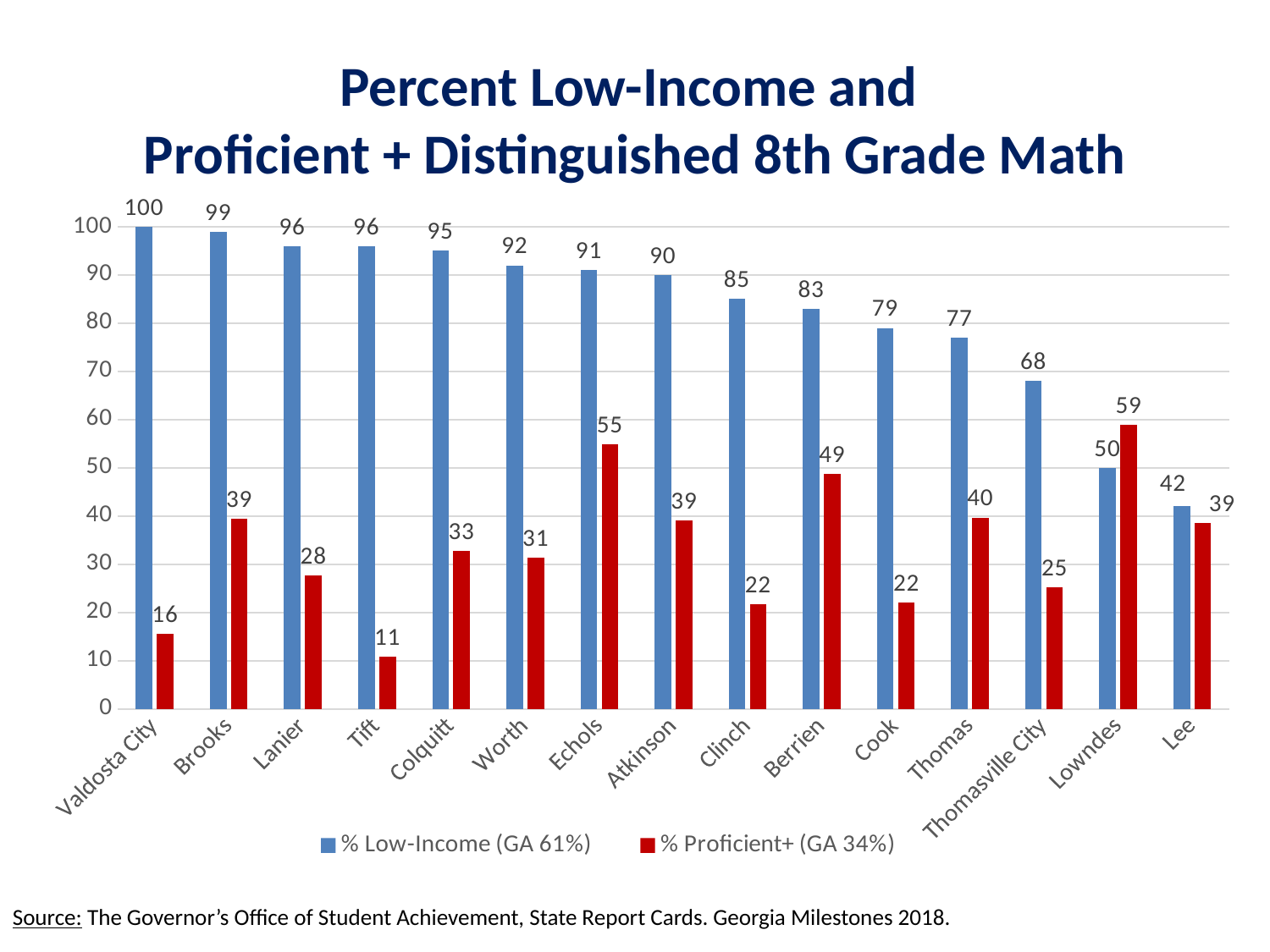
How many districts are shown on the x axis? 15 What is the difference between the % Low-Income and % Proficient+ values for Berrien? 34 Which is larger for Lowndes: the % Low-Income value or the % Proficient+ value? % Proficient+ What kind of chart is shown on the slide? Bar chart What is the % Proficient+ value for Tift? 11 Which district has the lowest % Low-Income value? Lee What colour are the % Proficient+ bars? Red Which district has the highest % Proficient+ value? Lowndes What is the % Proficient+ value for Clinch? 22 What is the % Low-Income value for Echols? 91 How many series does the legend list? 2 Do the % Low-Income values rise or fall from left to right along the x axis? Fall